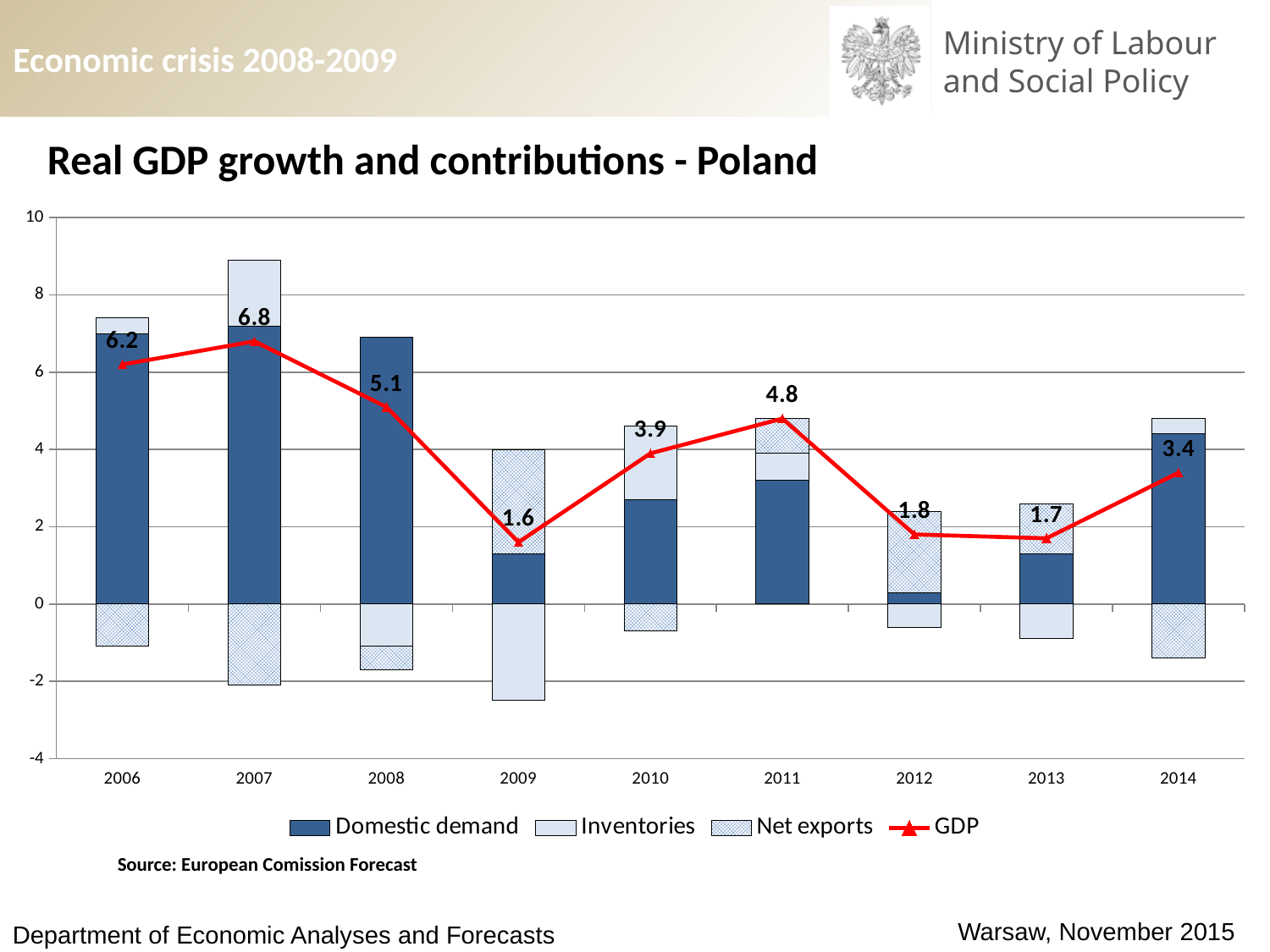
In which year is the GDP growth line at its lowest? 2009 Which year has the higher GDP growth value, 2008 or 2010? 2008 What is the difference between the GDP growth values for 2011 and 2010? 0.9 How many series does the legend list? 4 What is the GDP growth value shown for 2011? 4.8 Is the Domestic demand contribution for 2006 greater or less than 6? greater What is the GDP growth value shown for 2007? 6.8 In which year is the GDP growth line at its highest? 2007 What is the difference between the GDP growth values for 2007 and 2006? 0.6 How many years are shown on the x axis? 9 What is the GDP growth value shown for 2014? 3.4 Does the GDP growth line rise or fall from 2007 to 2009? fall